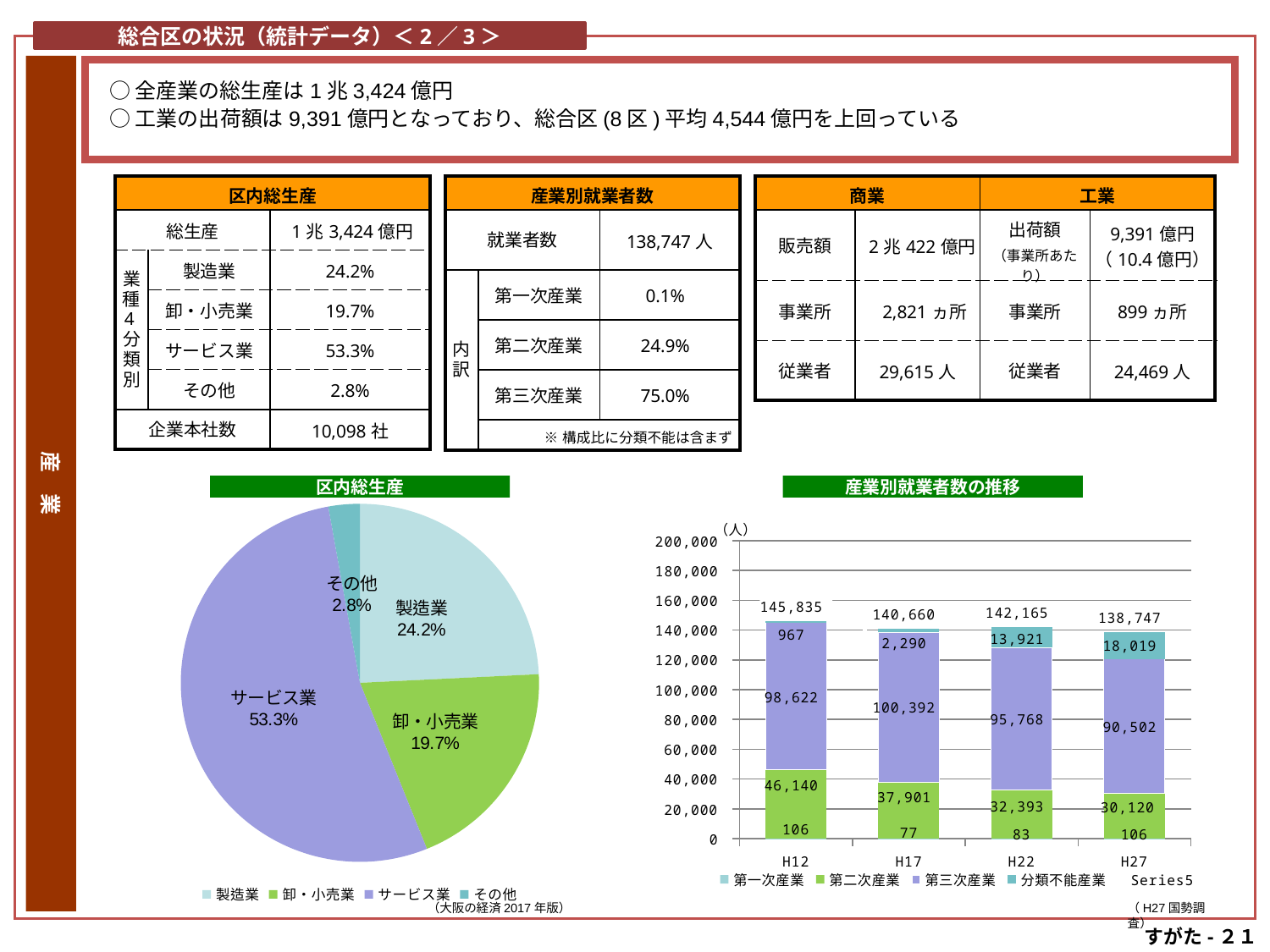
In the bar chart titled 産業別就業者数の推移, which year has the highest total? H12 In the pie chart titled 区内総生産, which category has the smallest slice? その他 In the pie chart titled 区内総生産, what is the difference in percentage points between 製造業 and 卸・小売業? 4.5 In the bar chart titled 産業別就業者数の推移, how many entries does the legend list? 5 In the bar chart titled 産業別就業者数の推移, is the 分類不能産業 value larger in H22 or H27? H27 In the pie chart titled 区内総生産, which category has the largest slice? サービス業 In the bar chart titled 産業別就業者数の推移, what is the value for 第三次産業 in H17? 100,392 In the bar chart titled 産業別就業者数の推移, what is the total of the stacked bar for H27? 138,747 In the pie chart titled 区内総生産, what share does サービス業 have? 53.3% In the bar chart titled 産業別就業者数の推移, does the 第二次産業 value rise or fall from H12 to H27? fall In the pie chart titled 区内総生産, how many slices are there? 4 In the bar chart titled 産業別就業者数の推移, what is the difference between the 第二次産業 values for H12 and H27? 16,020